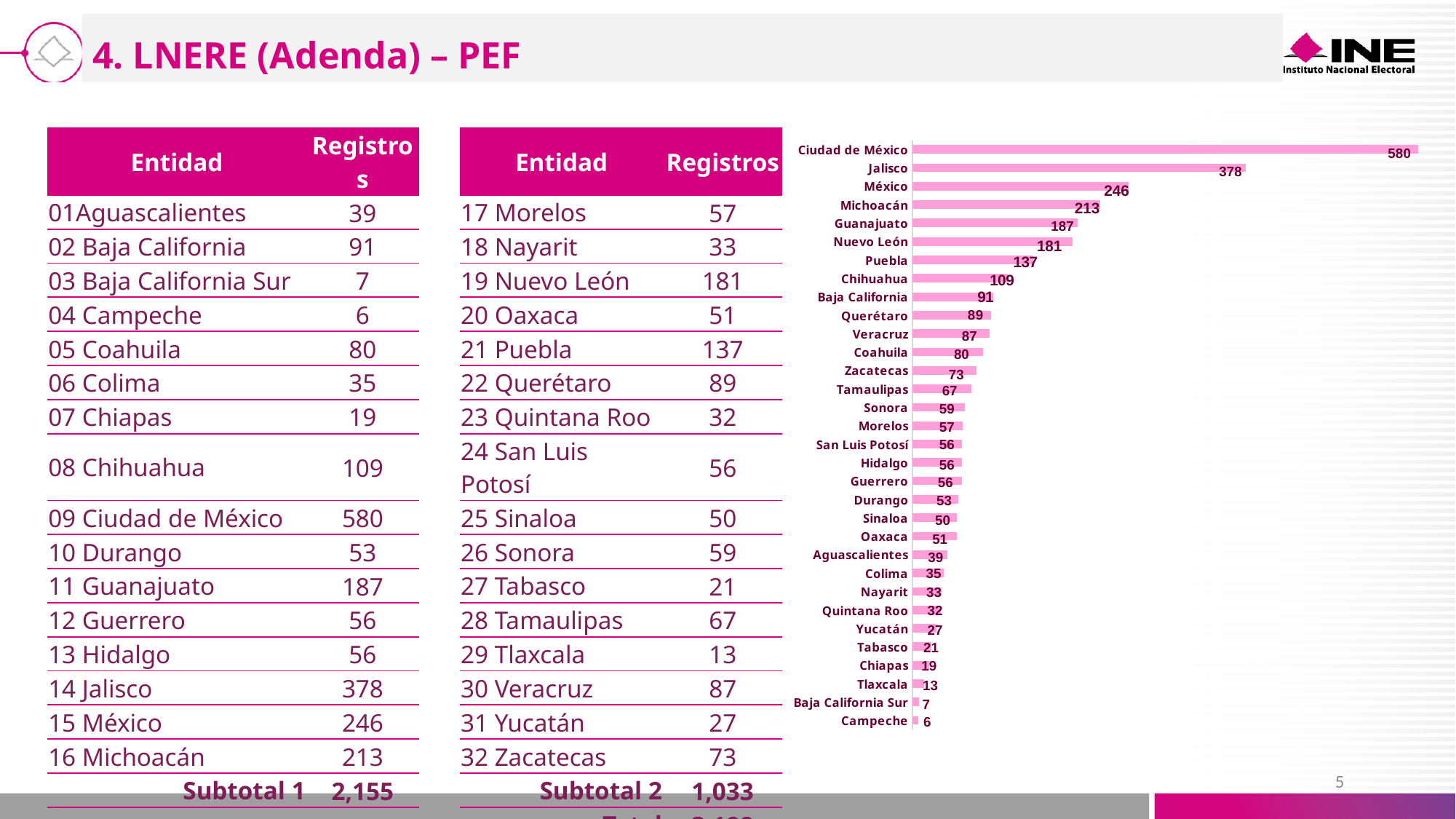
Which entity has the lowest value in the chart? Campeche What is the value for Ciudad de México in the chart? 580 How many entities are plotted in the chart? 32 What is the difference between the values for Ciudad de México and Jalisco? 202 Which has a larger value, Tabasco or Chiapas? Tabasco What is the value for Puebla in the chart? 137 What is the difference between the values for Michoacán and Guanajuato? 26 Do the bar values increase or decrease from the top of the chart to the bottom? decrease Which entity has the highest value in the chart? Ciudad de México What is the value for Zacatecas in the chart? 73 Which has a larger value, Nuevo León or Puebla? Nuevo León What type of chart is shown on the slide? bar chart